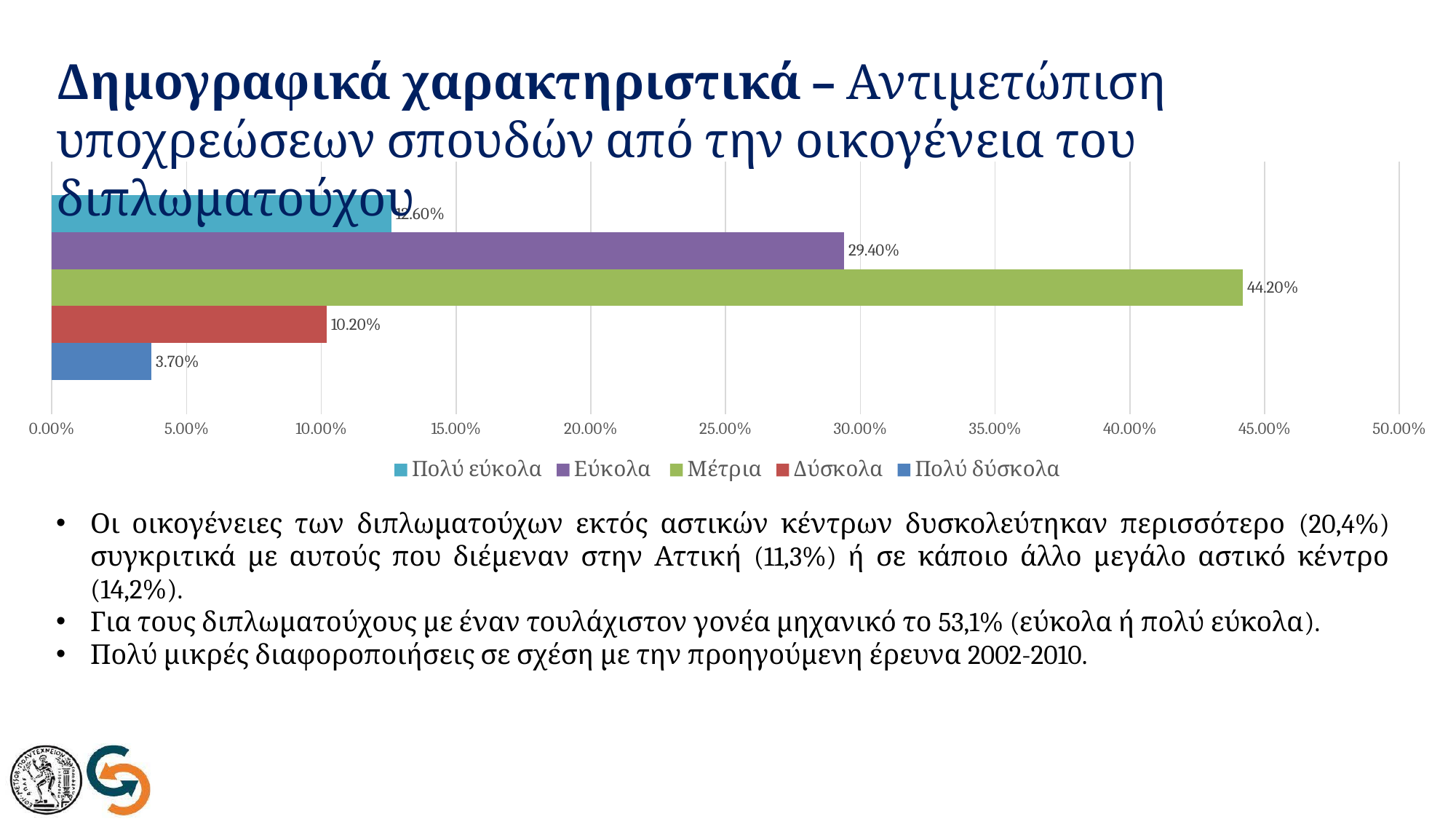
Is the value for Πολύ εύκολα greater or less than 10.00%? greater What is the value for Πολύ δύσκολα? 3.70% How many series does the legend list? 5 What is the value for Εύκολα? 29.40% What is the value for Μέτρια? 44.20% What kind of chart is shown on the slide? bar chart Which category has the lowest value? Πολύ δύσκολα What is the difference between the values for Μέτρια and Εύκολα? 14.80% What is the value for Δύσκολα? 10.20% Which category has the highest value? Μέτρια What is the difference between the values for Δύσκολα and Πολύ δύσκολα? 6.50% Which is larger, the value for Εύκολα or the value for Δύσκολα? Εύκολα